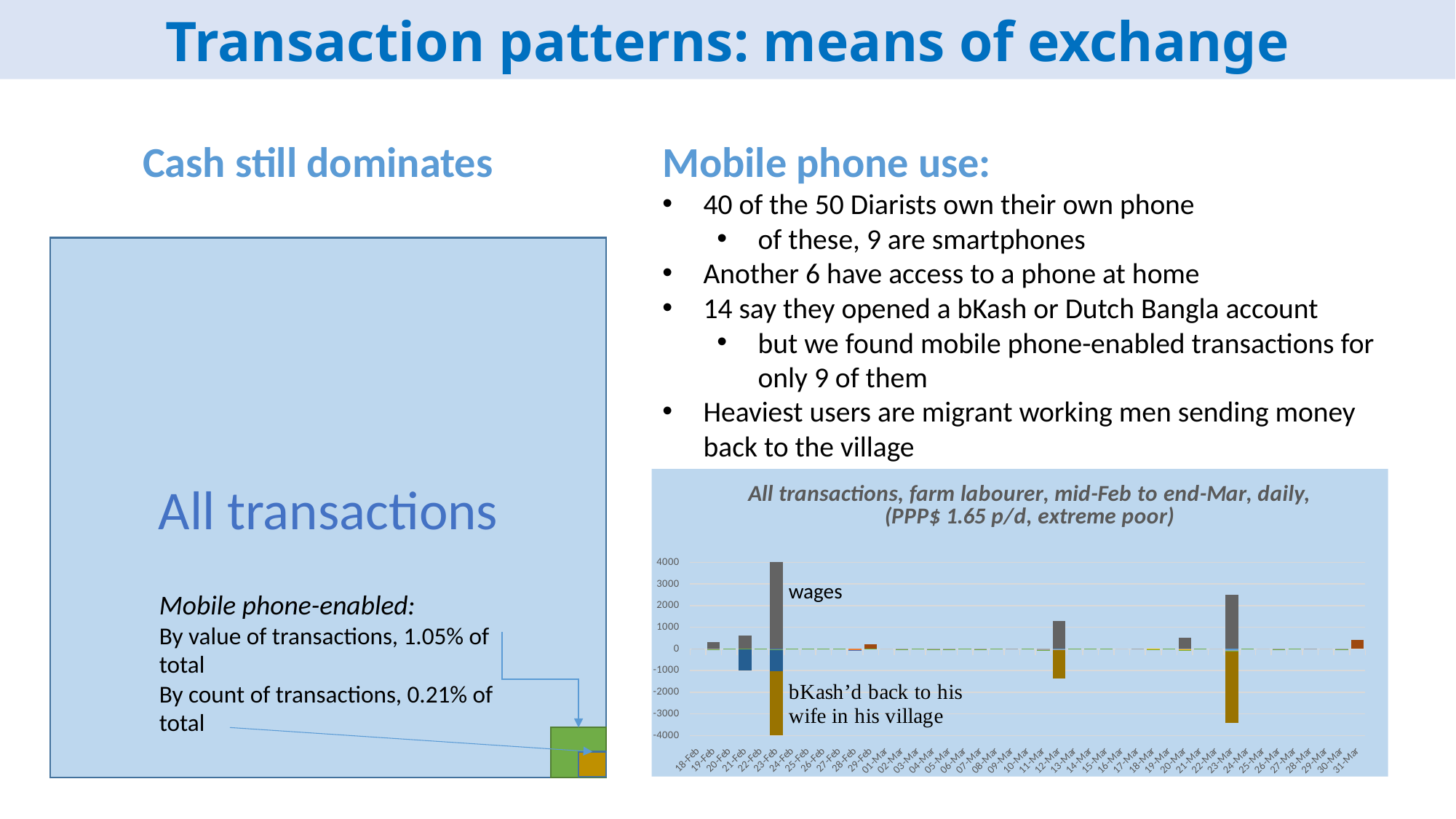
What is the title of the chart on the right side of the slide? All transactions, farm labourer, mid-Feb to end-Mar, daily, (PPP$ 1.65 p/d, extreme poor) What kind of chart is shown on the right side of the slide? bar chart In the chart on the right, on which date does the lowest negative bar occur? 23-Feb In the chart on the right, what does the annotation next to the large negative bars say? bKash'd back to his wife in his village In the chart on the right, is the positive (wages) value on 23-Feb greater or less than 3000? greater In the chart on the right, on which date does the tallest positive bar occur? 23-Feb In the chart on the right, is the positive value on 21-Feb greater or less than 1000? less In the chart on the right, which date has the larger positive bar, 23-Feb or 24-Mar? 23-Feb In the chart on the right, what is the highest value shown on the vertical axis? 4000 In the chart on the right, is the negative value on 23-Feb greater or less than -3000? less